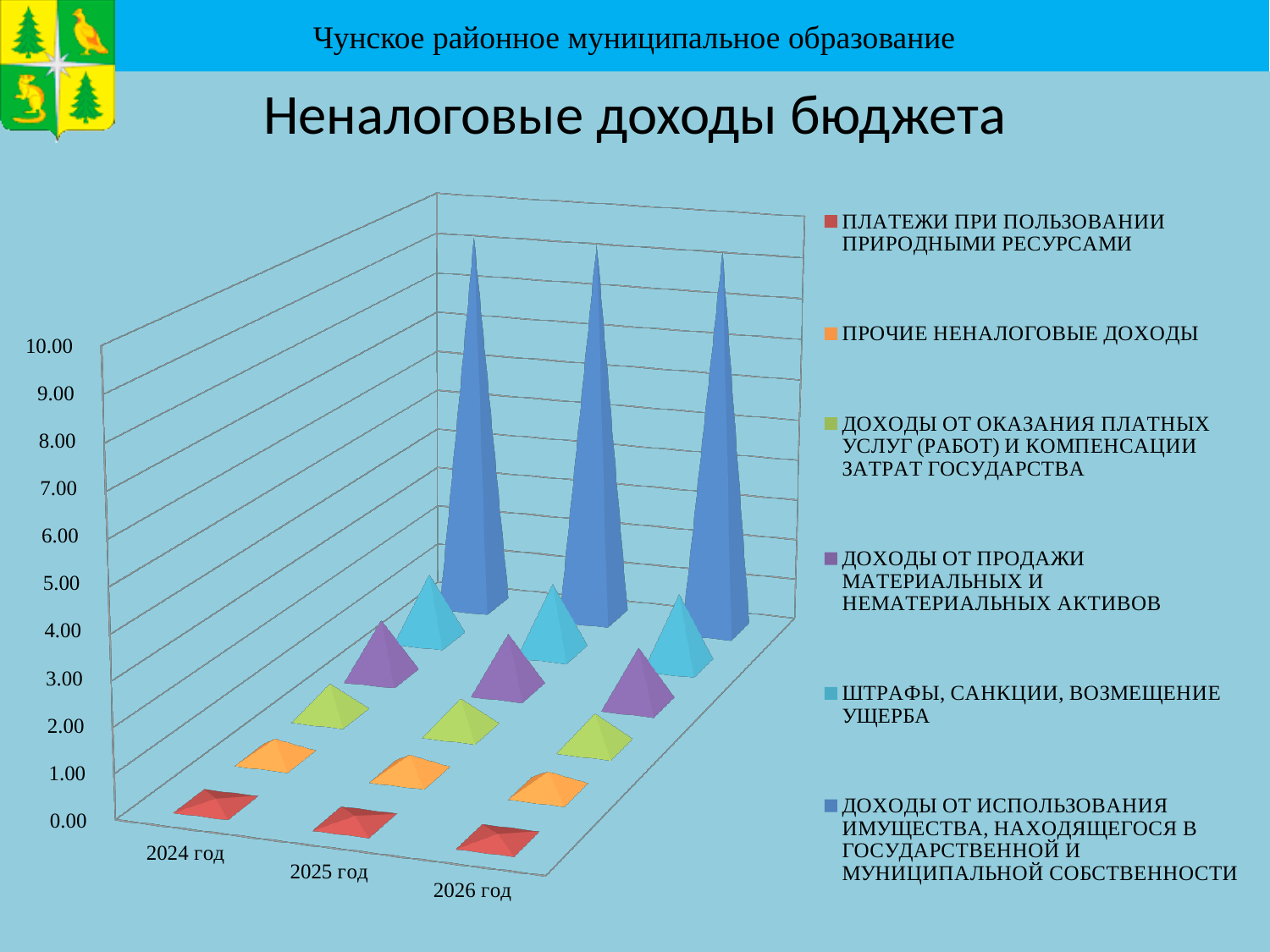
How many series does the chart legend list? 6 In 2026 год, which is larger: ШТРАФЫ, САНКЦИИ, ВОЗМЕЩЕНИЕ УЩЕРБА or ПЛАТЕЖИ ПРИ ПОЛЬЗОВАНИИ ПРИРОДНЫМИ РЕСУРСАМИ? ШТРАФЫ, САНКЦИИ, ВОЗМЕЩЕНИЕ УЩЕРБА Which series has the lowest value in 2025 год? ПЛАТЕЖИ ПРИ ПОЛЬЗОВАНИИ ПРИРОДНЫМИ РЕСУРСАМИ What colour represents ШТРАФЫ, САНКЦИИ, ВОЗМЕЩЕНИЕ УЩЕРБА in the chart legend? light blue What kind of chart is shown on the slide? bar chart In 2024 год, which is larger: ДОХОДЫ ОТ ИСПОЛЬЗОВАНИЯ ИМУЩЕСТВА or ПРОЧИЕ НЕНАЛОГОВЫЕ ДОХОДЫ? ДОХОДЫ ОТ ИСПОЛЬЗОВАНИЯ ИМУЩЕСТВА Which series has the highest value in 2026 год? ДОХОДЫ ОТ ИСПОЛЬЗОВАНИЯ ИМУЩЕСТВА, НАХОДЯЩЕГОСЯ В ГОСУДАРСТВЕННОЙ И МУНИЦИПАЛЬНОЙ СОБСТВЕННОСТИ Is the value for ДОХОДЫ ОТ ИСПОЛЬЗОВАНИЯ ИМУЩЕСТВА in 2024 год greater or less than 5.00? greater How many categories (years) are shown on the x axis of the chart? 3 Which series has the highest value in 2024 год? ДОХОДЫ ОТ ИСПОЛЬЗОВАНИЯ ИМУЩЕСТВА, НАХОДЯЩЕГОСЯ В ГОСУДАРСТВЕННОЙ И МУНИЦИПАЛЬНОЙ СОБСТВЕННОСТИ Is the value for ПЛАТЕЖИ ПРИ ПОЛЬЗОВАНИИ ПРИРОДНЫМИ РЕСУРСАМИ in 2024 год greater or less than 2.00? less What is the title of the chart on the slide? Неналоговые доходы бюджета